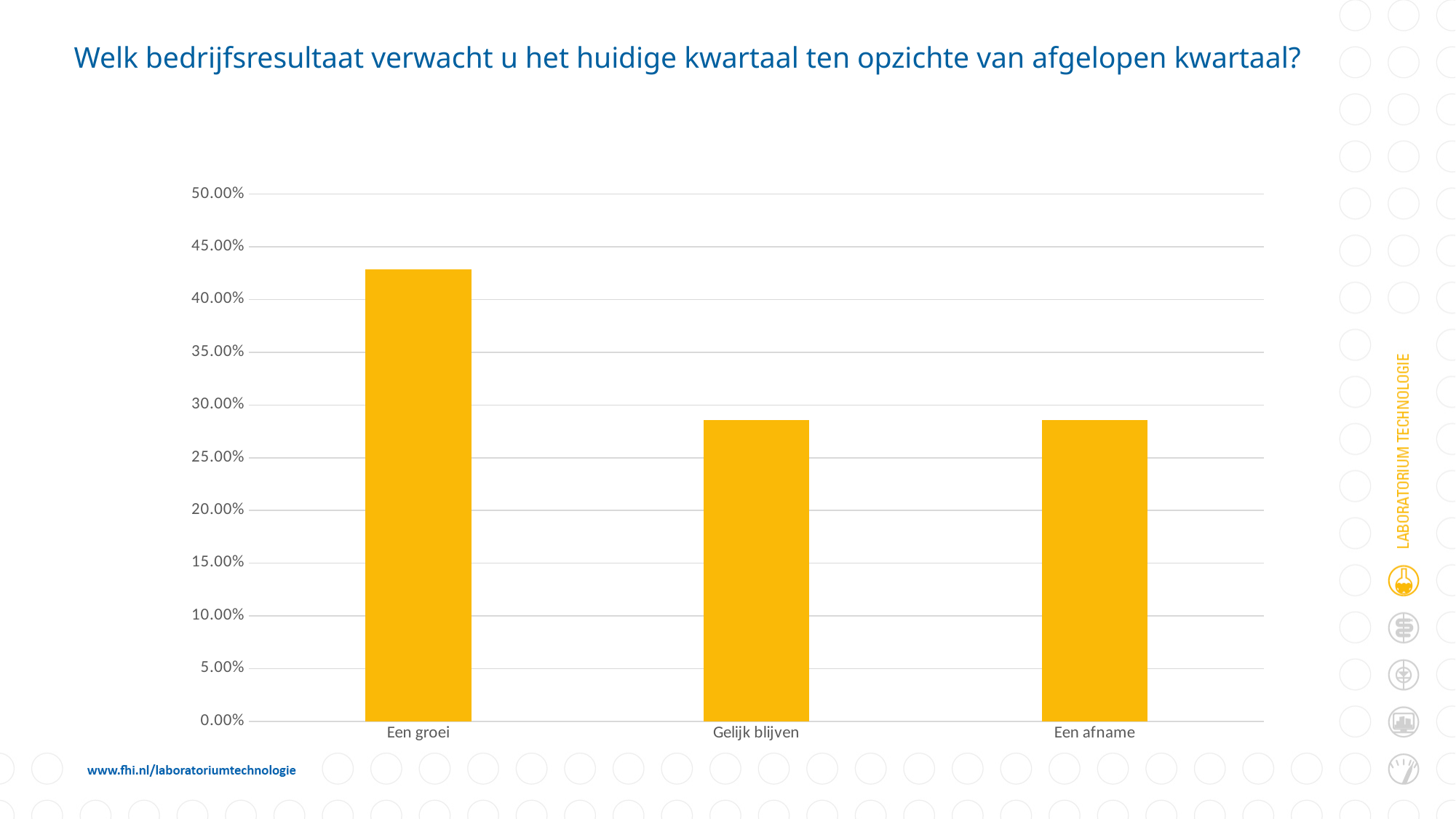
Which is larger, the value for Een groei or the value for Een afname? Een groei What colour are the bars in the chart? yellow Is the value for Een groei greater or less than 45.00%? less Is the value for Gelijk blijven greater or less than 30.00%? less What kind of chart is shown on the slide? bar chart What is the title of the slide above the chart? Welk bedrijfsresultaat verwacht u het huidige kwartaal ten opzichte van afgelopen kwartaal? How many categories are shown on the x axis of the chart? 3 Is the value for Een groei greater or less than 40.00%? greater Which category has the highest value in the chart? Een groei